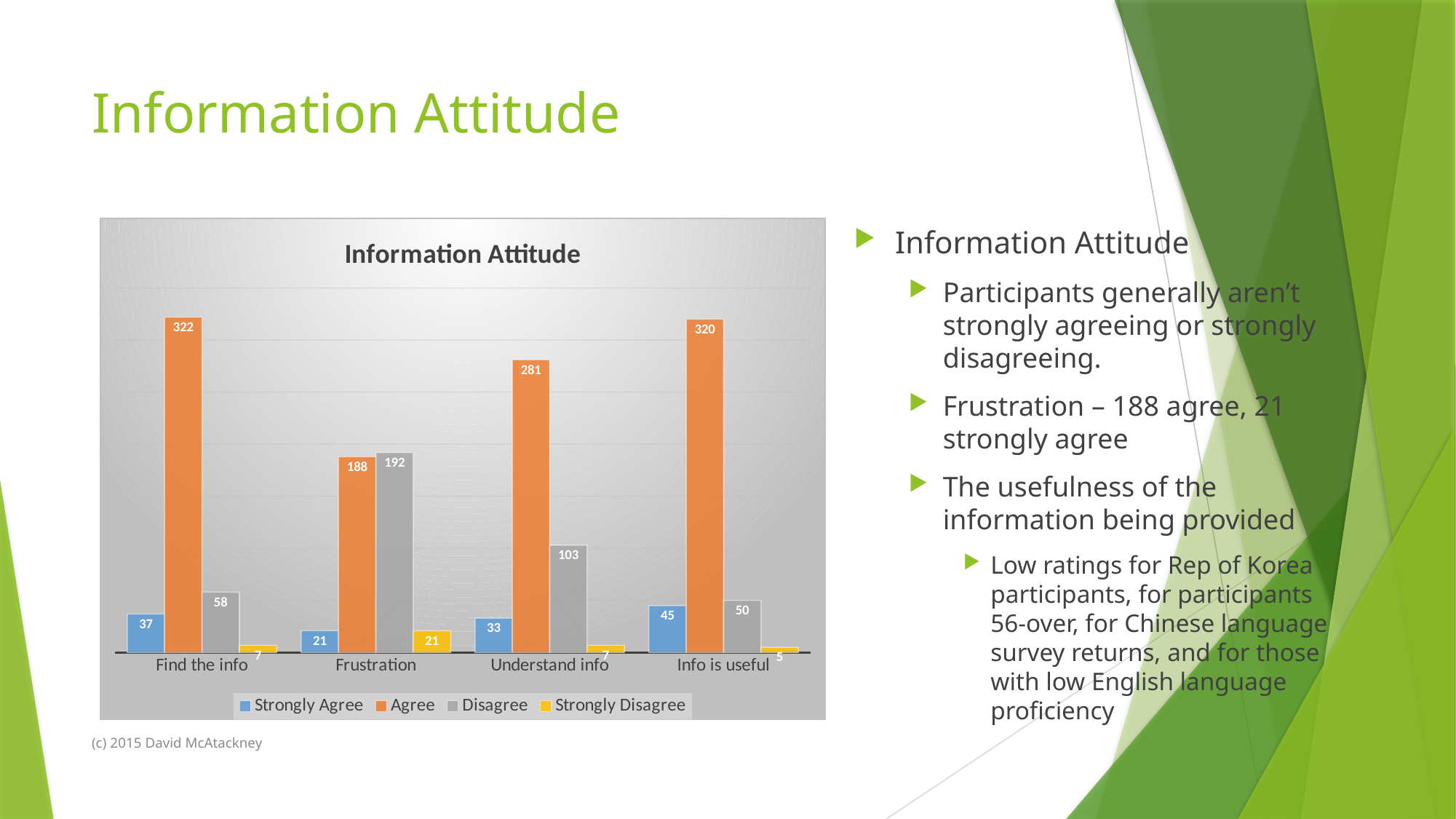
How many series does the legend list? 4 How many categories are shown on the x axis? 4 What is the difference between the Agree and Disagree values in the Understand info category? 178 Which is larger in the Frustration category, Agree or Disagree? Disagree What kind of chart is shown on the slide? Bar chart What is the value for Agree in the Find the info category? 322 What is the value for Strongly Disagree in the Understand info category? 7 What is the title of the chart? Information Attitude What is the value for Disagree in the Frustration category? 192 Which category has the lowest Strongly Disagree value? Info is useful What is the value for Strongly Agree in the Info is useful category? 45 Which category has the highest Agree value? Find the info